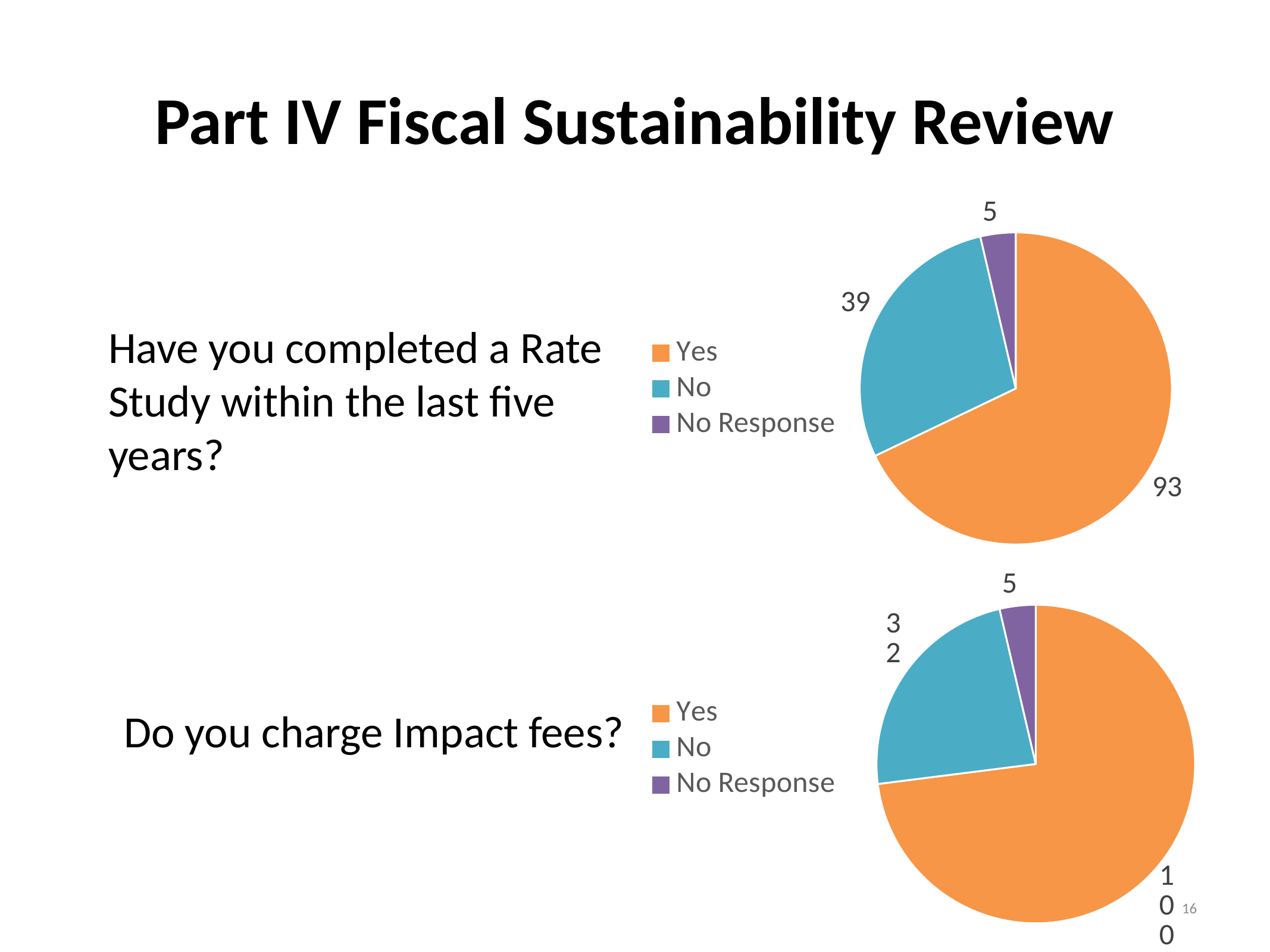
What type of chart is used for 'Do you charge Impact fees?' Pie chart How many entries does the legend of the 'Do you charge Impact fees?' chart list? 3 In the pie chart for 'Have you completed a Rate Study within the last five years?', what is the total of all slices? 137 In the pie chart for 'Have you completed a Rate Study within the last five years?', which category has the smallest slice? No Response In the pie chart for 'Have you completed a Rate Study within the last five years?', how many respondents answered No? 39 In the pie chart for 'Have you completed a Rate Study within the last five years?', what is the difference between the Yes and No values? 54 In the pie chart for 'Do you charge Impact fees?', how many respondents answered No? 32 In the pie chart for 'Have you completed a Rate Study within the last five years?', what is the value for No Response? 5 In the pie chart for 'Do you charge Impact fees?', which is larger, Yes or No? Yes In the pie chart for 'Have you completed a Rate Study within the last five years?', how many respondents answered Yes? 93 In the pie chart for 'Have you completed a Rate Study within the last five years?', which category has the largest slice? Yes In the pie chart for 'Do you charge Impact fees?', how many respondents answered Yes? 100